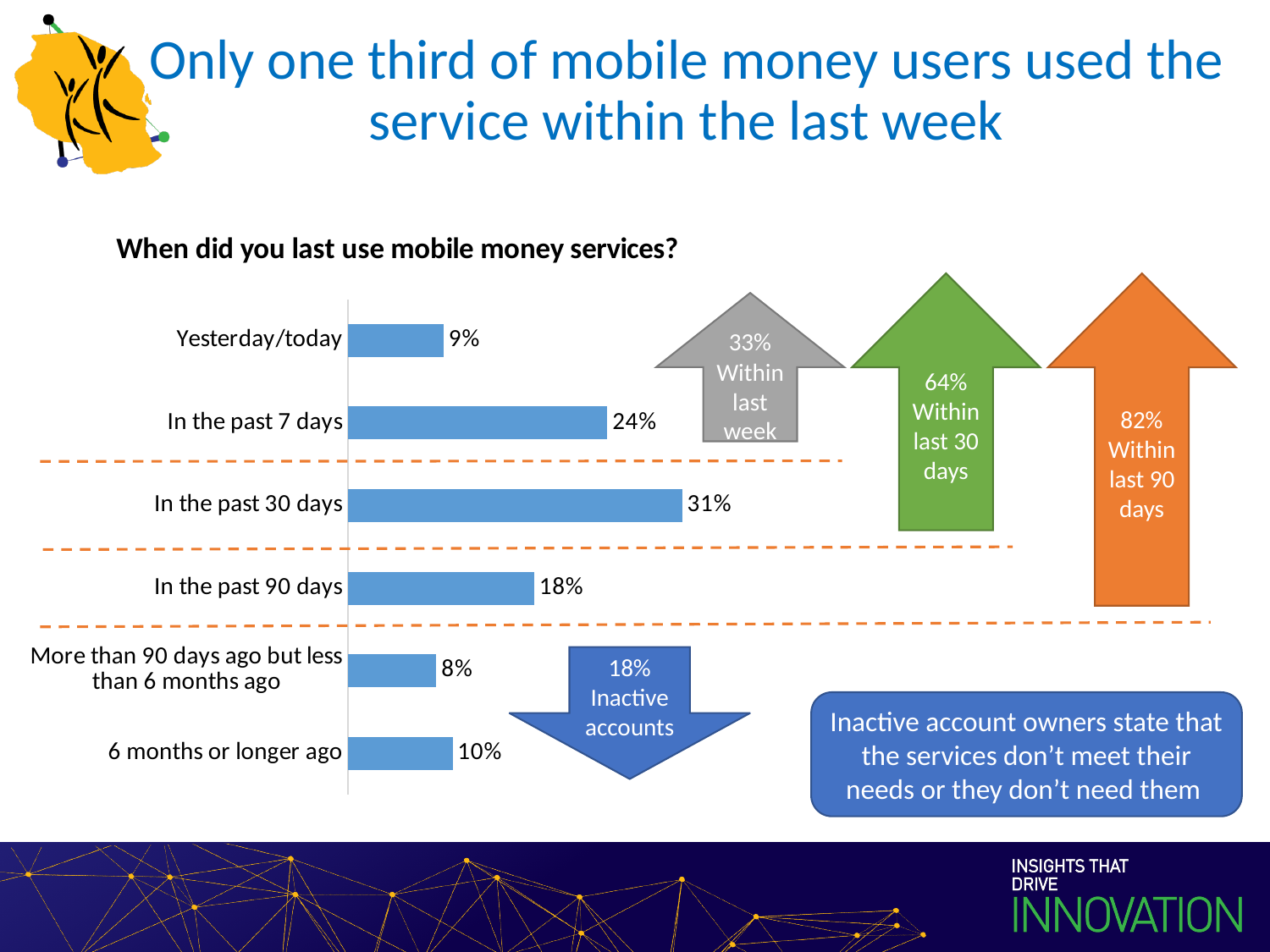
Which is larger: the value for 'In the past 7 days' or the value for '6 months or longer ago'? In the past 7 days Which category has the lowest percentage in the chart? More than 90 days ago but less than 6 months ago What value is shown for 'In the past 30 days'? 31% What percentage of users last used mobile money services 6 months or longer ago? 10% What type of chart is used to show when users last used mobile money services? Bar chart How many categories are shown in the bar chart? 6 What percentage of users last used mobile money services in the past 7 days? 24% What is the difference between the 'In the past 30 days' value and the 'In the past 90 days' value? 13% What question does the chart title ask? When did you last use mobile money services? Which category has the highest percentage in the chart? In the past 30 days What is the combined percentage of users who used the service yesterday/today or in the past 7 days? 33% What percentage of mobile money users last used the service yesterday/today? 9%